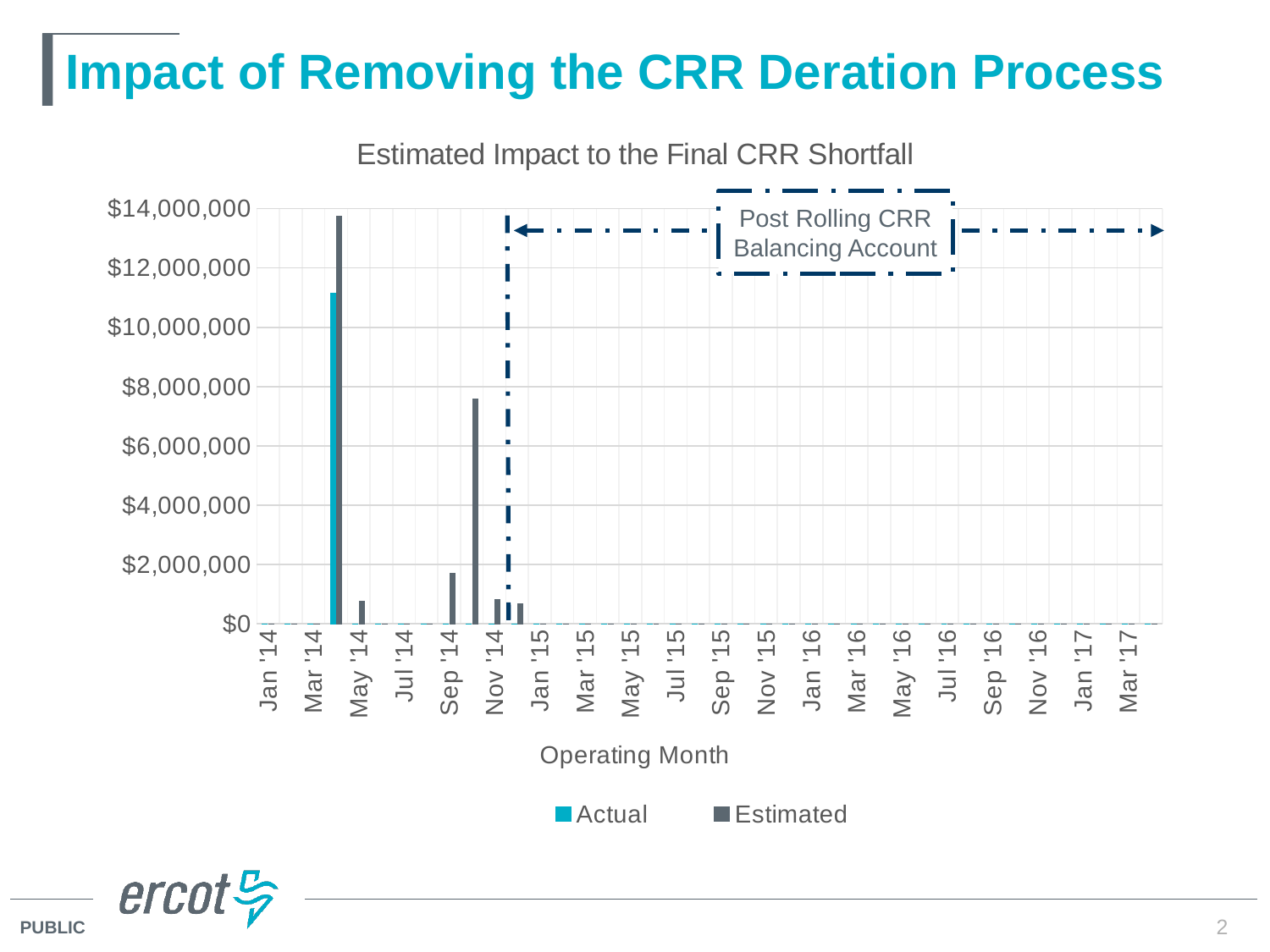
Do the plotted values generally rise or fall along the x axis after Mar '14? fall What is the title of the chart? Estimated Impact to the Final CRR Shortfall What kind of chart is shown on the slide? Bar chart What text appears in the dashed annotation box on the chart? Post Rolling CRR Balancing Account Is the Estimated value for Sep '14 greater or less than $2,000,000? less Is the Estimated value for May '14 greater or less than $2,000,000? less How many series does the legend list? 2